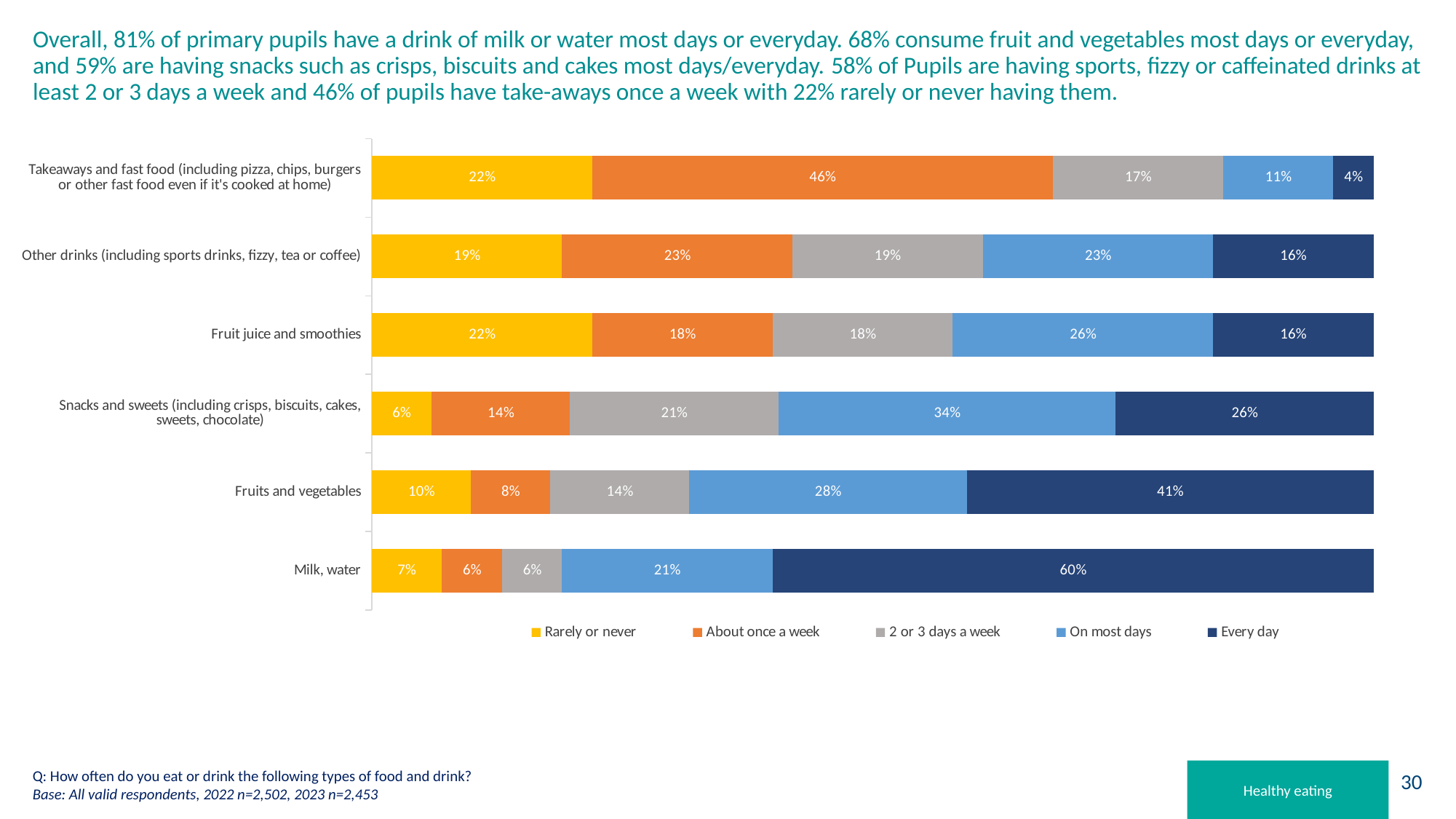
What percentage of pupils eat snacks and sweets on most days? 34% What percentage of pupils have milk or water every day? 60% Which is larger: the 'On most days' percentage for fruit juice and smoothies or for other drinks? Fruit juice and smoothies What percentage of pupils rarely or never have fruit juice and smoothies? 22% What is the difference between the 'Every day' percentages for fruits and vegetables and for snacks and sweets? 15% What percentage of pupils have takeaways and fast food about once a week? 46% Which food or drink category has the highest 'Every day' percentage? Milk, water Which food or drink category has the lowest 'Every day' percentage? Takeaways and fast food (including pizza, chips, burgers or other fast food even if it's cooked at home) Which colour represents 'Rarely or never' in the chart? Yellow How many series does the legend list? 5 How many food and drink categories are shown in the chart? 6 What kind of chart is shown on the slide? Stacked bar chart